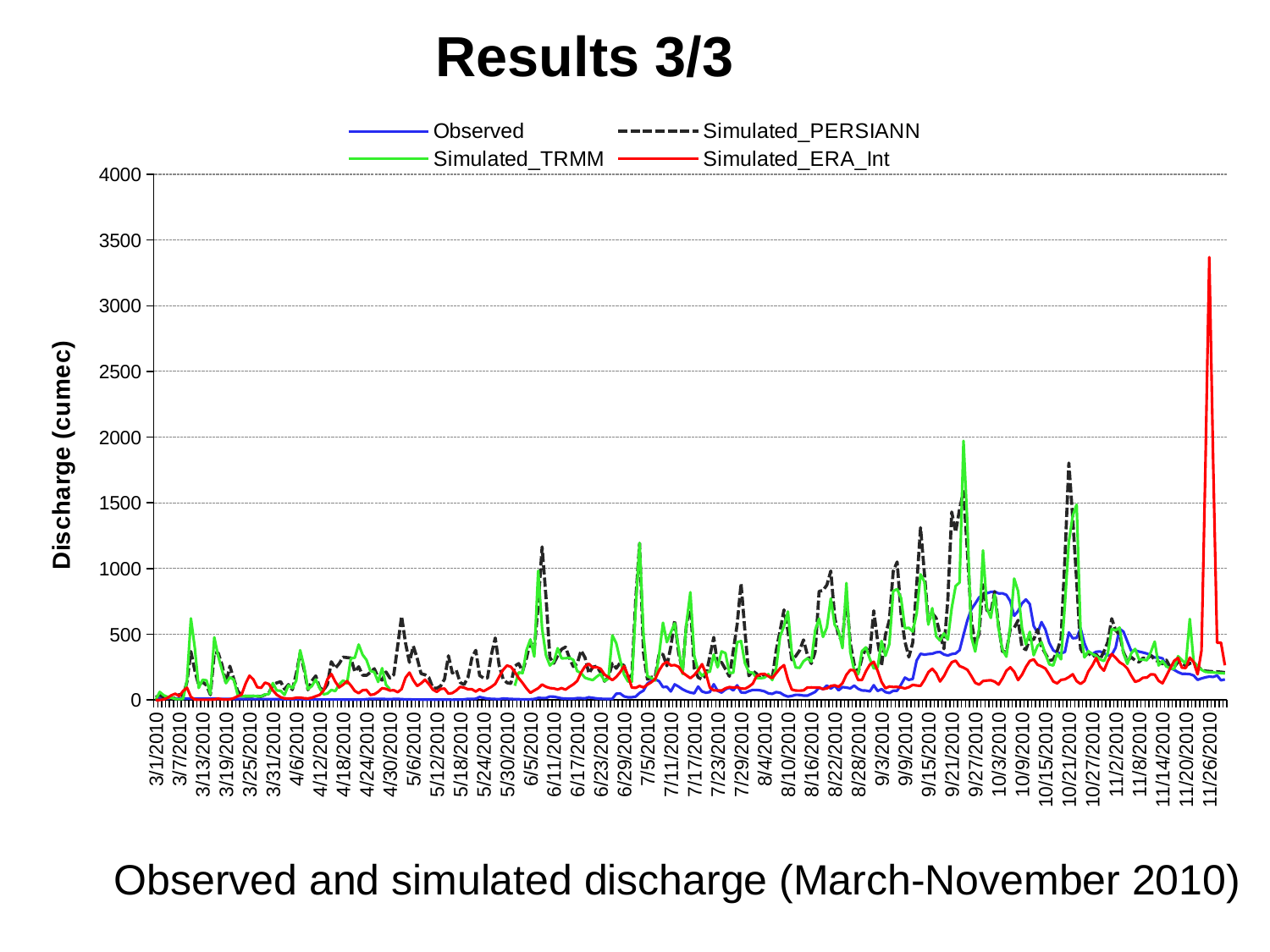
What is the maximum value shown on the vertical axis? 4000 Is the highest peak of Simulated_TRMM greater or less than 1500? greater What is the label of the vertical axis? Discharge (cumec) Is the peak of Simulated_PERSIANN around 10/21/2010 greater or less than 1500? greater Which is larger, the highest peak of Simulated_ERA_Int or the highest peak of Simulated_TRMM? Simulated_ERA_Int Is the highest peak of Simulated_ERA_Int greater or less than 3000? greater How many series does the legend list? 4 Which series is drawn as a dashed line? Simulated_PERSIANN Which series reaches the highest peak value on the chart? Simulated_ERA_Int What kind of chart is shown on the slide? line chart